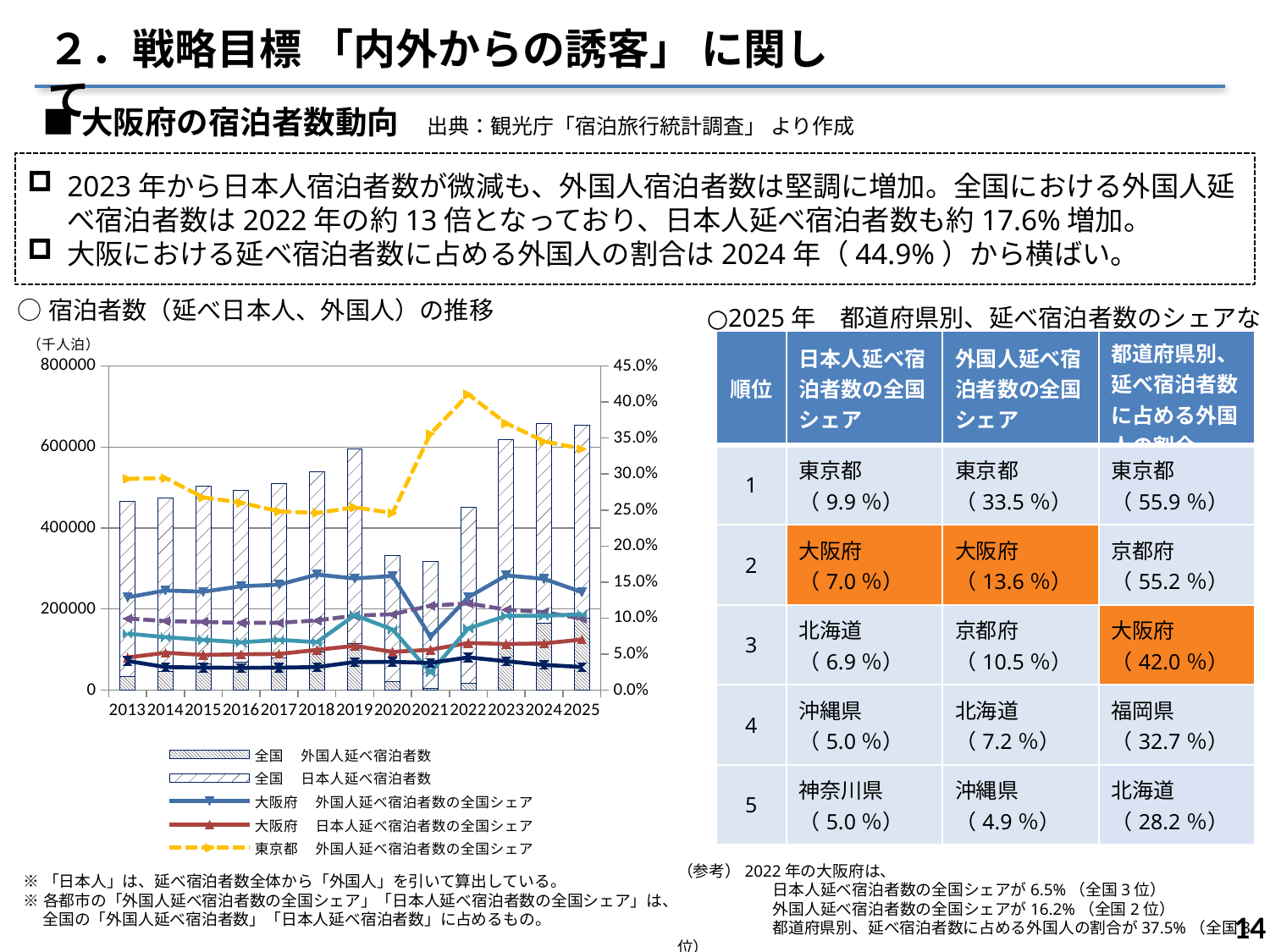
In the 宿泊者数（延べ日本人、外国人）の推移 chart, which is larger: the 全国 日本人延べ宿泊者数 bar for 2019 or for 2020? 2019 What unit is shown at the top of the left axis of the 宿泊者数（延べ日本人、外国人）の推移 chart? 千人泊 In the 宿泊者数（延べ日本人、外国人）の推移 chart, which is larger in 2022: the 東京都 外国人延べ宿泊者数の全国シェア or the 大阪府 外国人延べ宿泊者数の全国シェア? 東京都 外国人延べ宿泊者数の全国シェア In the 宿泊者数（延べ日本人、外国人）の推移 chart, is the 全国 日本人延べ宿泊者数 bar for 2024 greater or less than 600000? less In the 宿泊者数（延べ日本人、外国人）の推移 chart, in which year is the 大阪府 外国人延べ宿泊者数の全国シェア line at its lowest? 2021 In the 宿泊者数（延べ日本人、外国人）の推移 chart, in which year is the 全国 外国人延べ宿泊者数 bar the lowest? 2021 In the 宿泊者数（延べ日本人、外国人）の推移 chart, is the 全国 外国人延べ宿泊者数 bar for 2024 greater or less than 200000? less In the 宿泊者数（延べ日本人、外国人）の推移 chart, does the 東京都 外国人延べ宿泊者数の全国シェア line rise or fall from 2022 to 2025? fall In the 宿泊者数（延べ日本人、外国人）の推移 chart, in which year does the 東京都 外国人延べ宿泊者数の全国シェア line reach its highest point? 2022 What kind of chart is the 宿泊者数（延べ日本人、外国人）の推移 chart? A combination bar and line chart How many years are shown on the x axis of the 宿泊者数（延べ日本人、外国人）の推移 chart? 13 In the 宿泊者数（延べ日本人、外国人）の推移 chart, is the 大阪府 外国人延べ宿泊者数の全国シェア value for 2025 greater or less than 10.0%? greater